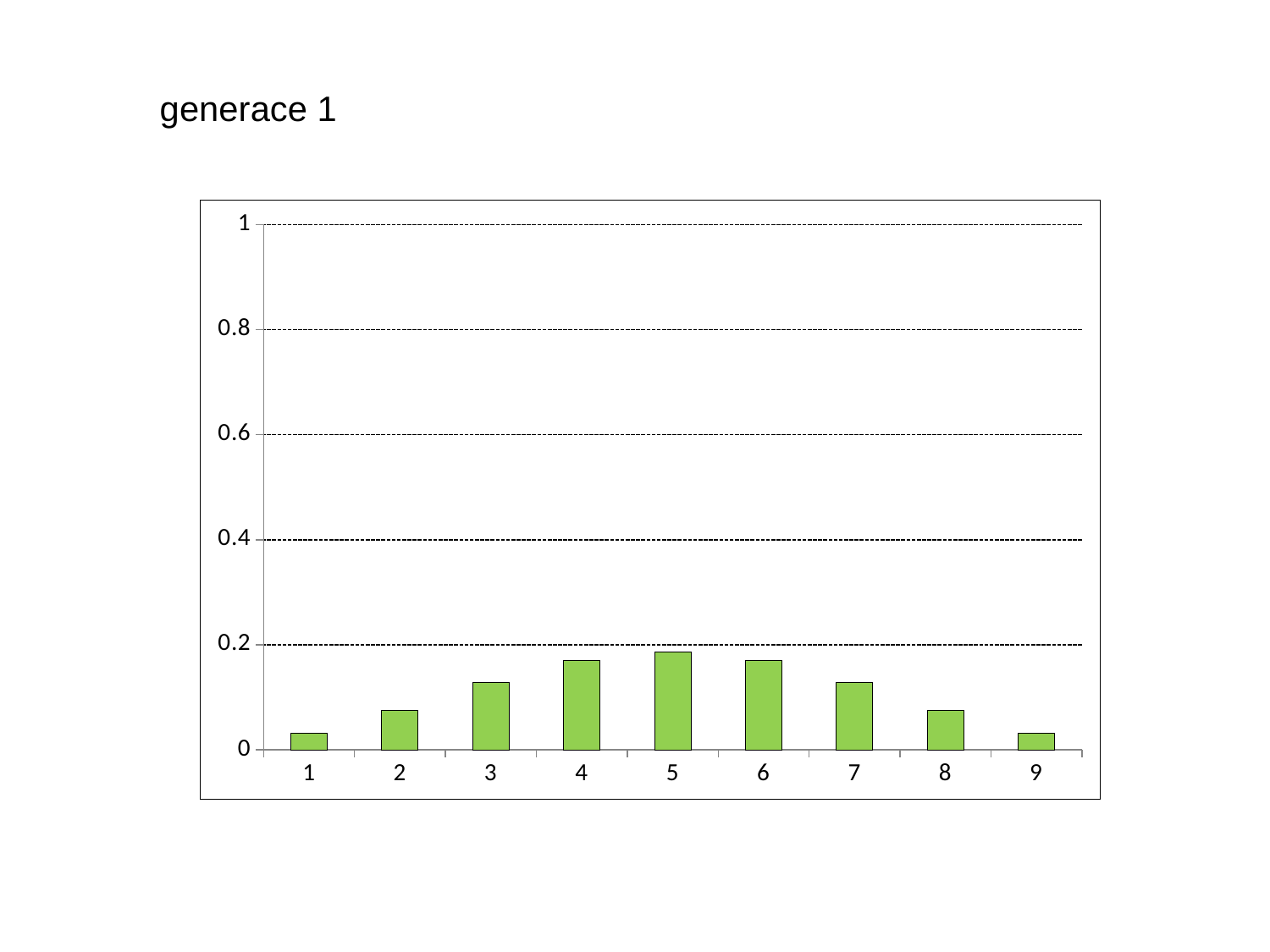
How many categories are plotted on the x axis? 9 Is the value for category 5 greater or less than 0.2? less What colour are the bars in the chart? green Which is larger, the value for category 4 or the value for category 2? category 4 What kind of chart is shown on the slide? bar chart Do the values rise or fall from category 1 to category 5? rise Which category has the highest bar? 5 Do the values rise or fall from category 5 to category 9? fall Which is larger, the value for category 7 or the value for category 9? category 7 Is the value for category 4 greater or less than 0.4? less Is the value for category 1 greater or less than 0.2? less What is the title shown above the chart on the slide? generace 1